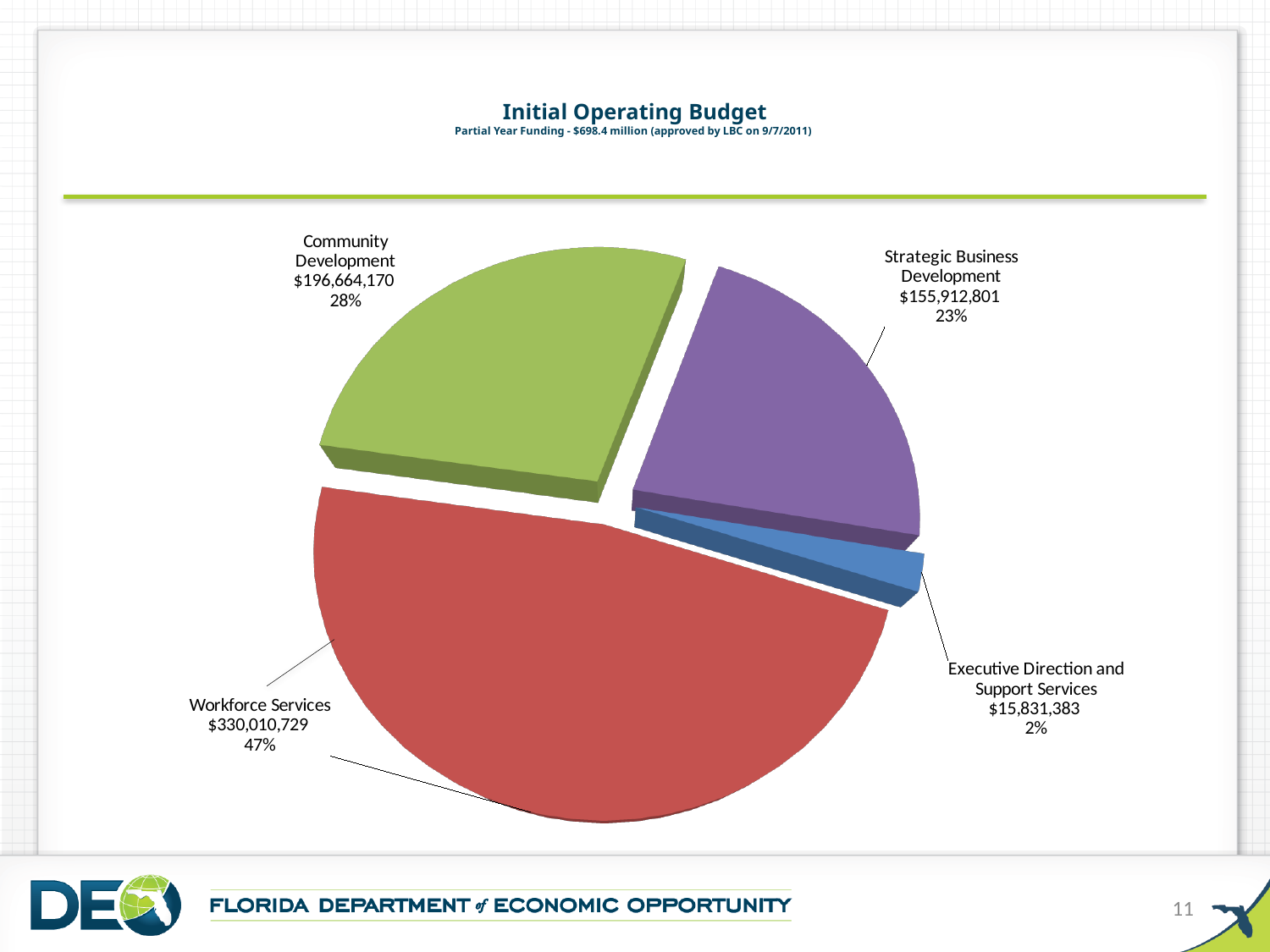
What share of the pie does Strategic Business Development represent? 23% What is the dollar value for Executive Direction and Support Services? $15,831,383 Which category has the largest slice of the pie? Workforce Services What is the difference in dollars between Workforce Services and Community Development? $133,346,559 Which category has the smallest slice of the pie? Executive Direction and Support Services What kind of chart is shown on the slide? pie chart What share of the pie does Community Development represent? 28% What is the dollar value for Community Development? $196,664,170 What is the title of the chart? Initial Operating Budget What is the dollar value for Strategic Business Development? $155,912,801 What is the dollar value for Workforce Services? $330,010,729 How many slices does the pie chart have? 4